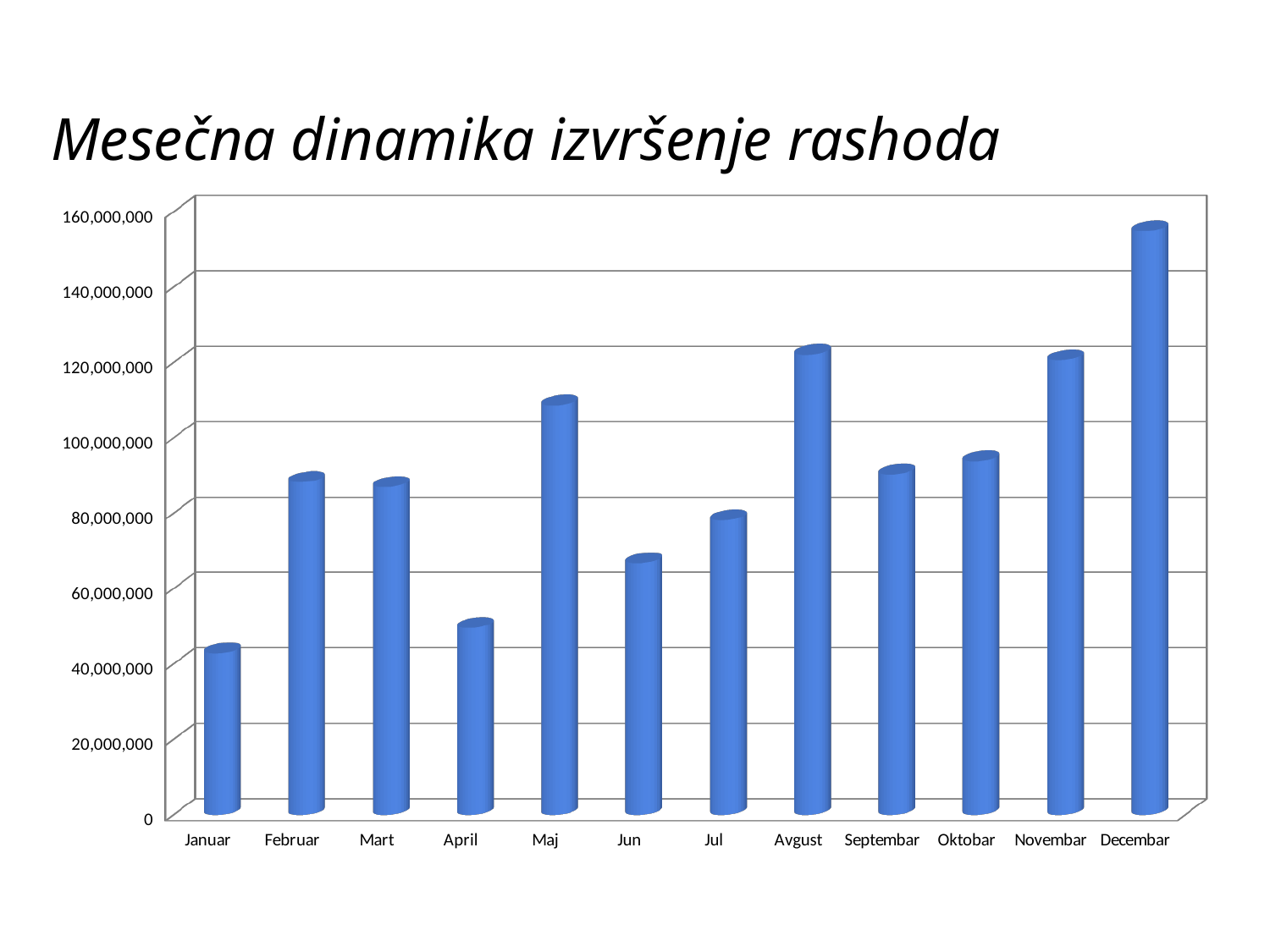
Is the value for Maj greater or less than 100,000,000? greater Which month has the lowest value? Januar Which is larger, the value for Maj or the value for Jun? Maj Is the value for Januar greater or less than 60,000,000? less Is the value for Decembar greater or less than 140,000,000? greater What is the title of the chart? Mesečna dinamika izvršenje rashoda What kind of chart is shown on the slide? bar chart Which is larger, the value for April or the value for Jul? Jul How many months (categories) are shown on the x axis? 12 Which month has the highest value? Decembar Does the value rise or fall from Maj to Jun? fall